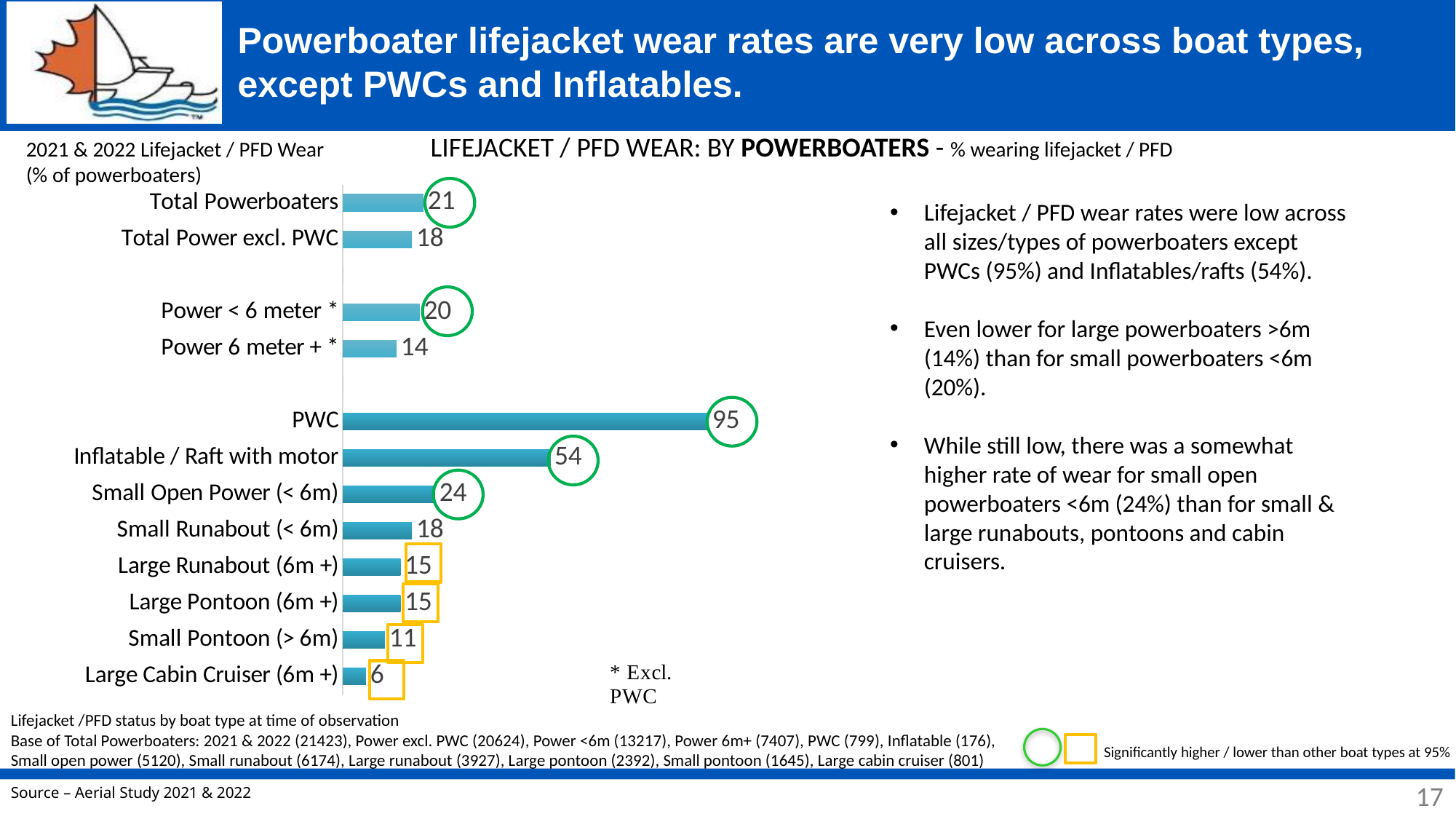
Which boat type has the lowest lifejacket wear rate? Large Cabin Cruiser (6m +) What is the difference between the values for PWC and Inflatable / Raft with motor? 41 What is the difference between the values for Power < 6 meter * and Power 6 meter + *? 6 Which boat type has the highest lifejacket wear rate? PWC What is the value for Inflatable / Raft with motor? 54 What is the value for Total Powerboaters? 21 Which is larger, the value for Small Open Power (< 6m) or Small Runabout (< 6m)? Small Open Power (< 6m) How many bars are plotted in the chart? 12 What is the value for Large Cabin Cruiser (6m +)? 6 What is the value for Small Pontoon (> 6m)? 11 What is the value for PWC? 95 What kind of chart is shown on the slide? Bar chart